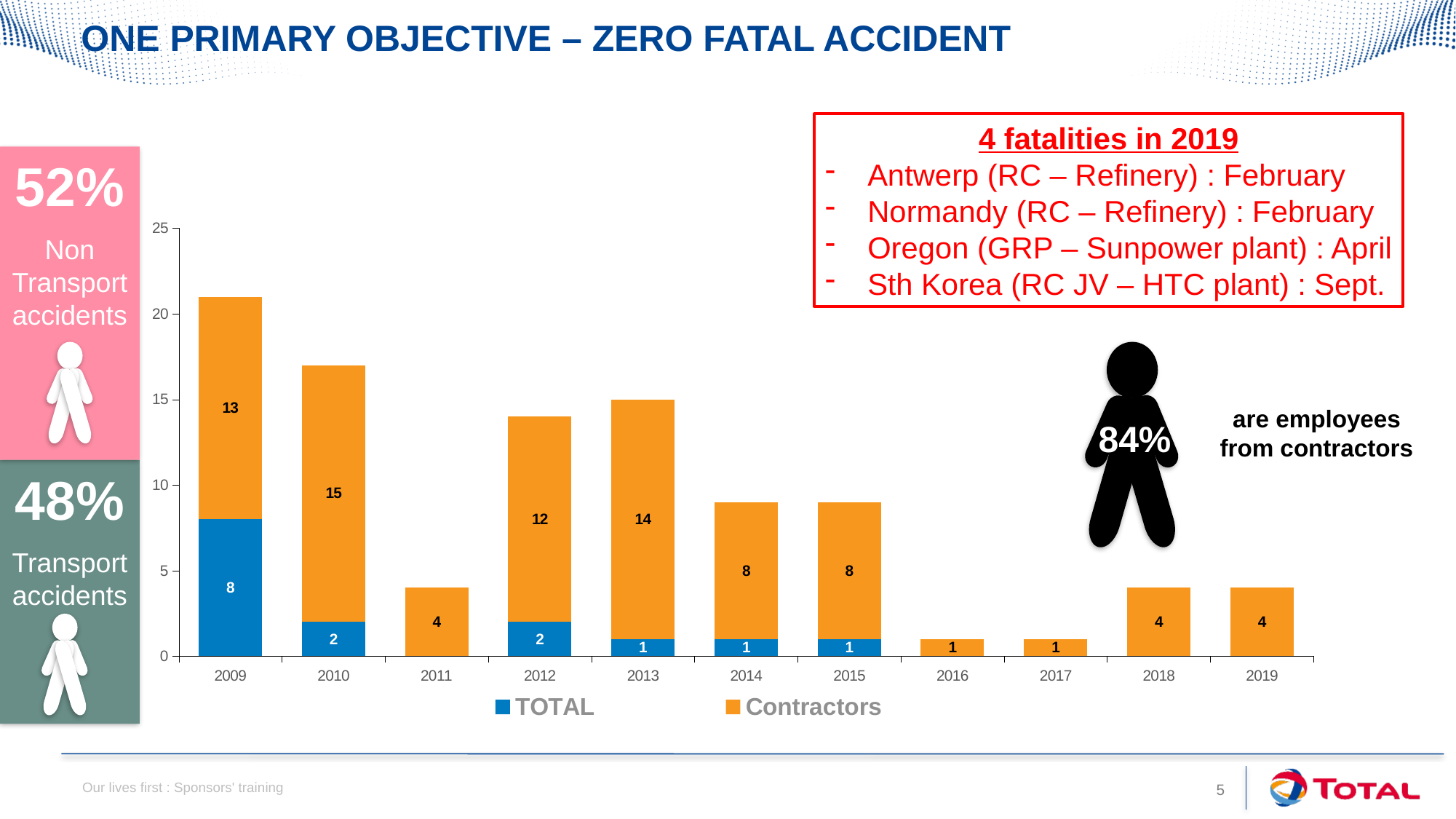
Is the total height of the stacked bar for 2010 greater or less than 15? greater Do the Contractors values rise or fall from 2013 to 2017? Fall What kind of chart is shown on the slide? Bar chart What is the total of the stacked bar for 2009? 21 What is the difference between the Contractors values for 2013 and 2012? 2 How many years are shown on the x axis of the chart? 11 How many series does the chart legend list? 2 What is the Contractors value for 2010? 15 What is the TOTAL value for 2009? 8 In which year is the Contractors value highest? 2010 Which year has the larger Contractors value, 2009 or 2013? 2013 In which year is the TOTAL value highest? 2009